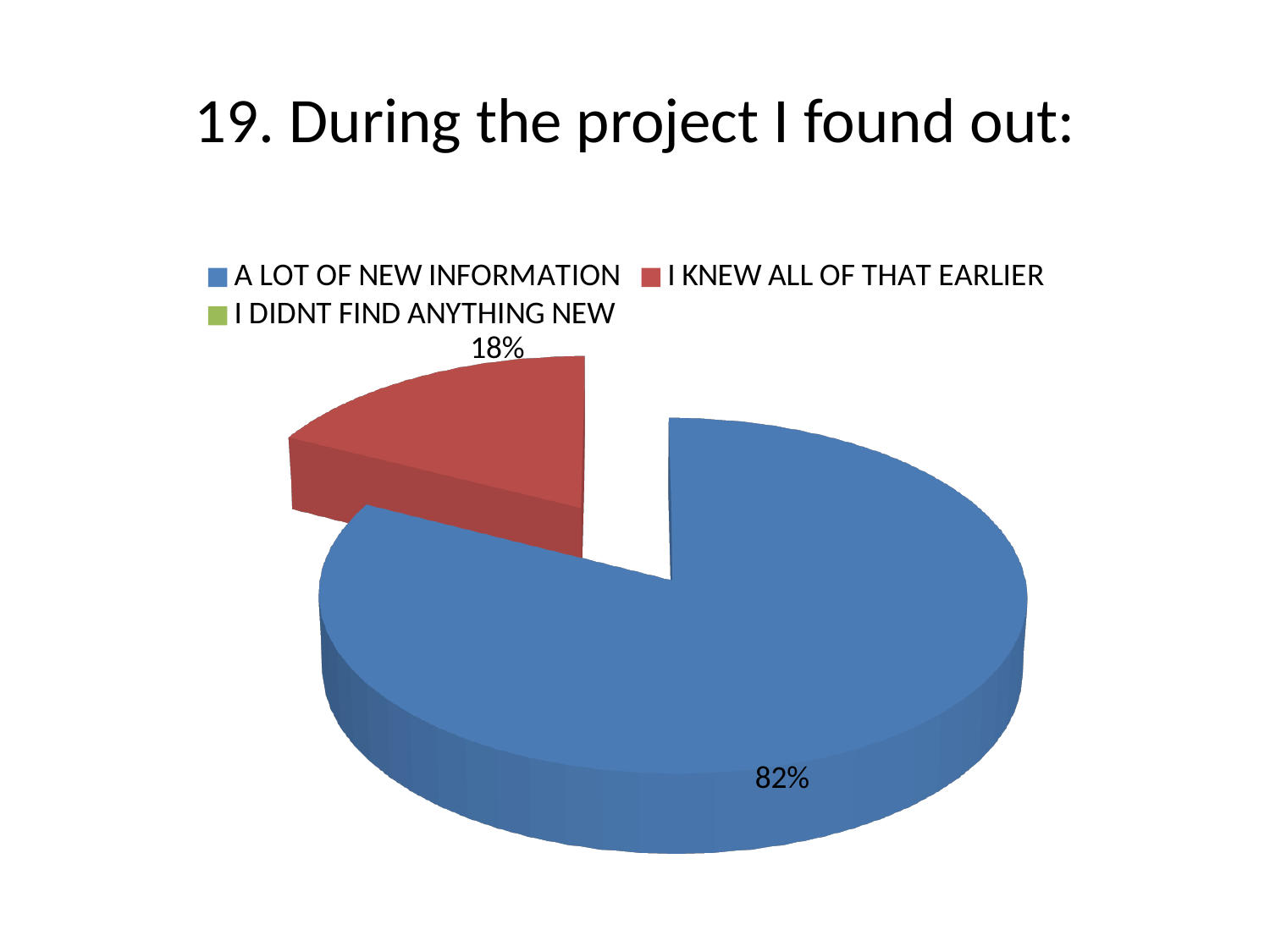
How many categories does the legend list? 3 What is the title of the slide containing the chart? 19. During the project I found out: Which category has the largest slice of the pie? A LOT OF NEW INFORMATION What colour is the slice for "I KNEW ALL OF THAT EARLIER"? Red What share of the pie does "I KNEW ALL OF THAT EARLIER" take? 18% Which legend category has no visible slice in the pie? I DIDNT FIND ANYTHING NEW Which of the two labelled slices is larger: "A LOT OF NEW INFORMATION" or "I KNEW ALL OF THAT EARLIER"? A LOT OF NEW INFORMATION What kind of chart is shown on the slide? Pie chart What share of the pie does "A LOT OF NEW INFORMATION" take? 82% What is the difference in percentage points between the "A LOT OF NEW INFORMATION" slice and the "I KNEW ALL OF THAT EARLIER" slice? 64 percentage points